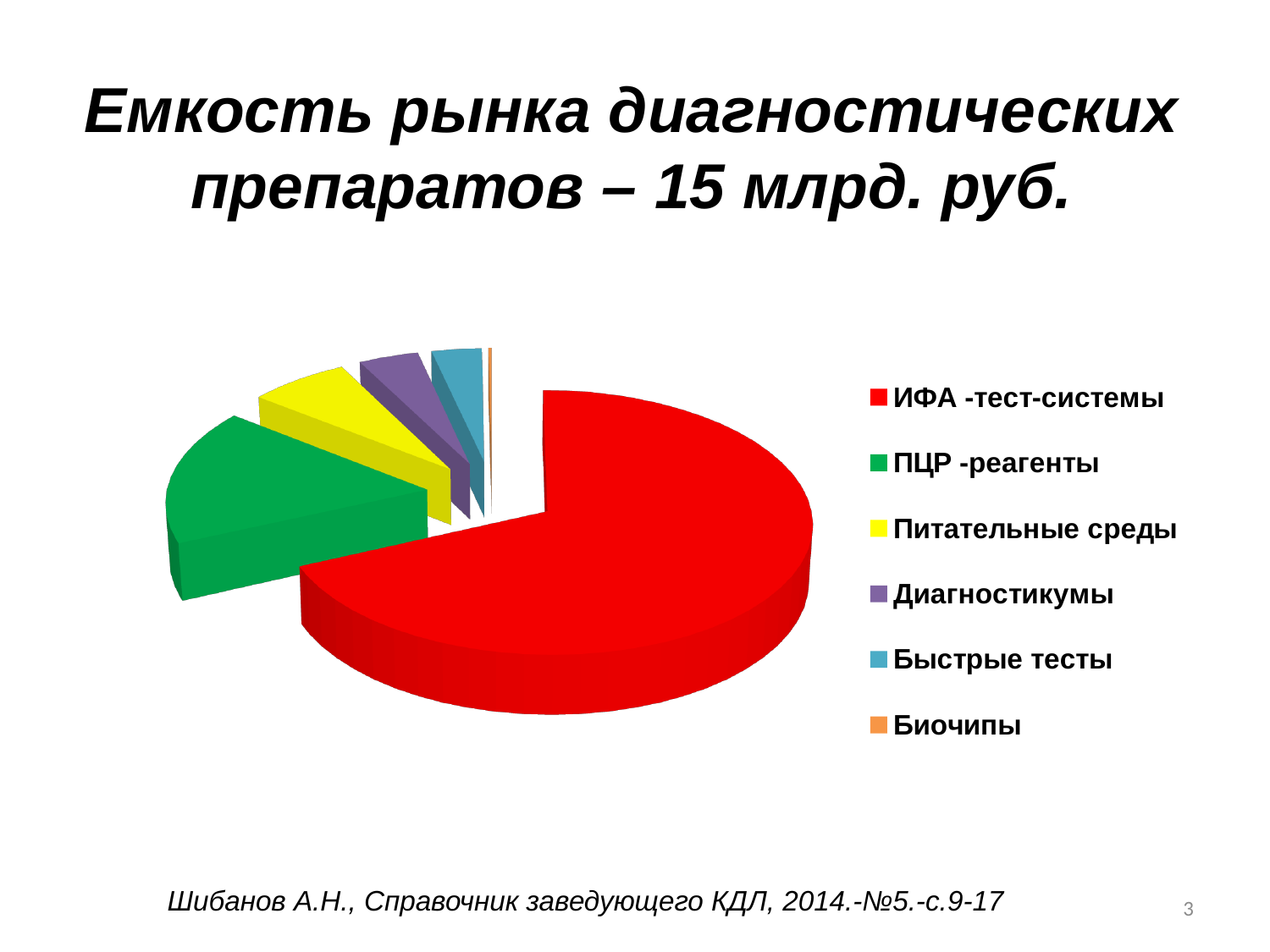
How many categories does the pie chart show? 6 Which slice is larger: ПЦР -реагенты or Питательные среды? ПЦР -реагенты What kind of chart is shown on the slide? pie chart Which category has the smallest slice of the pie? Биочипы What is the title of the slide containing the pie chart? Емкость рынка диагностических препаратов – 15 млрд. руб. Which category has the largest slice of the pie? ИФА -тест-системы Which slice is larger: Быстрые тесты or Биочипы? Быстрые тесты Which slice is larger: ИФА -тест-системы or ПЦР -реагенты? ИФА -тест-системы What colour is the ИФА -тест-системы slice in the pie chart? red